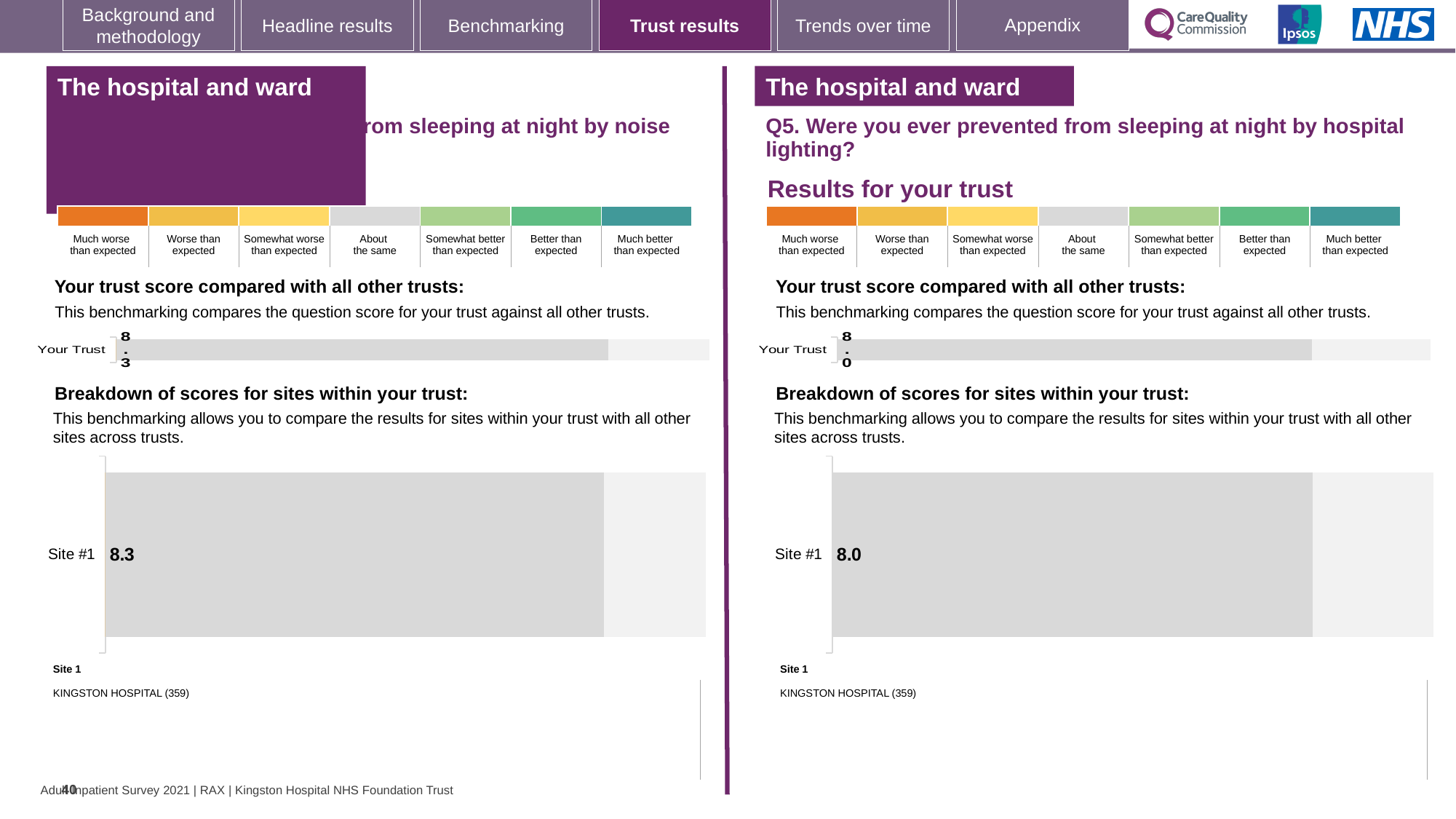
On the right-hand 'Breakdown of scores for sites within your trust' chart (Q5, hospital lighting), what is the score for Site #1? 8.0 On the right-hand 'Your trust score compared with all other trusts' chart (Q5, hospital lighting), what is the score shown for Your Trust? 8.0 Which site is listed as Site 1 beneath the right-hand breakdown chart? KINGSTON HOSPITAL (359) What kind of chart is used for the 'Breakdown of scores for sites within your trust' on the right-hand side? Bar chart What is the question text above the right-hand charts? Q5. Were you ever prevented from sleeping at night by hospital lighting? How many sites are shown on the left-hand 'Breakdown of scores for sites within your trust' chart? 1 What is the difference between the Your Trust score on the left-hand chart and the Your Trust score on the right-hand chart? 0.3 On the left-hand 'Breakdown of scores for sites within your trust' chart, what is the score for Site #1? 8.3 On the left-hand 'Your trust score compared with all other trusts' chart, what is the score shown for Your Trust? 8.3 How many sites are shown on the right-hand 'Breakdown of scores for sites within your trust' chart? 1 Which is larger: the Site #1 score on the left-hand breakdown chart or the Site #1 score on the right-hand breakdown chart? Left-hand (8.3)